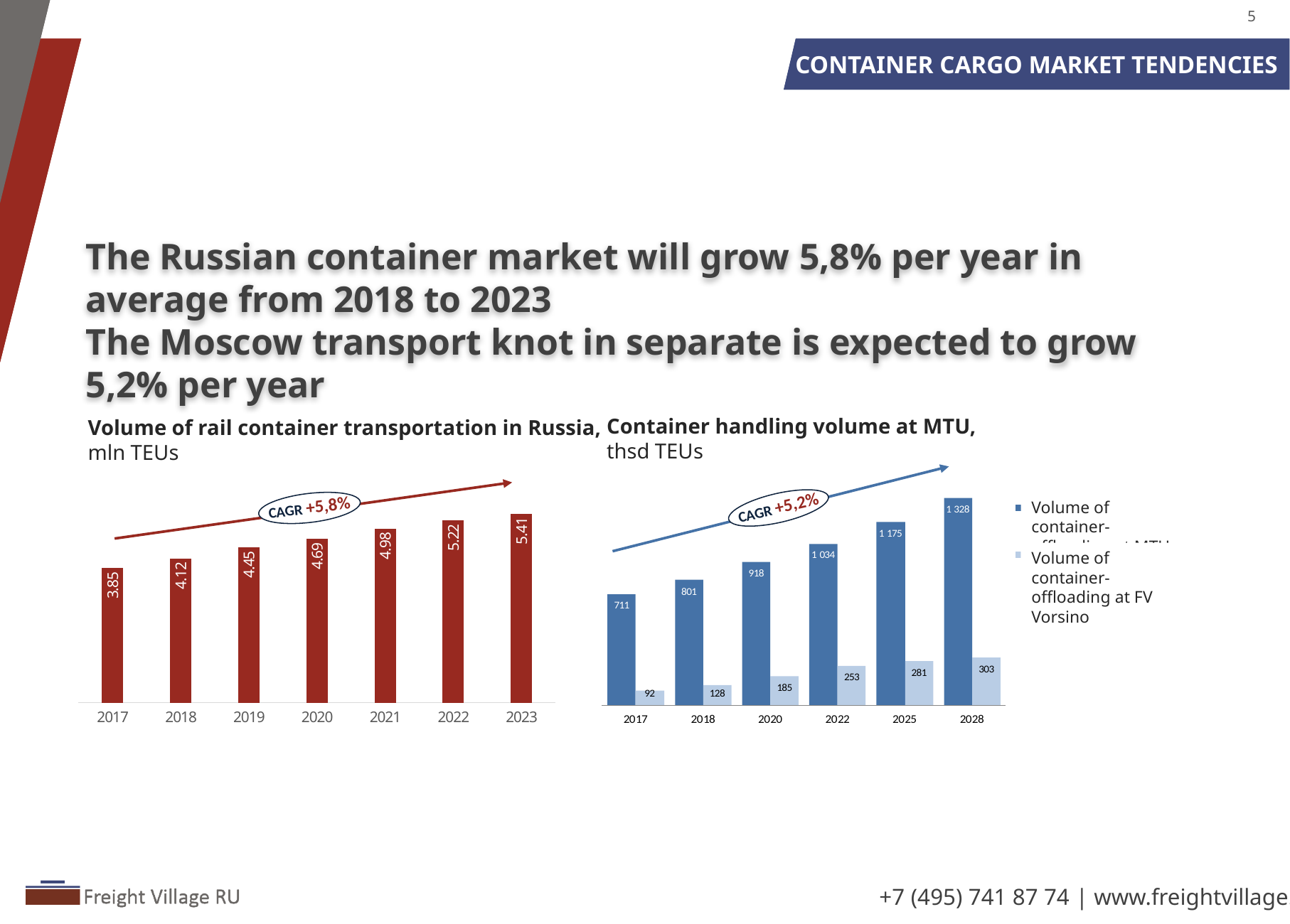
What kind of chart is 'Container handling volume at MTU'? bar chart In the chart 'Volume of rail container transportation in Russia', which year has the highest value? 2023 In the chart 'Volume of rail container transportation in Russia', what is the difference between the 2023 and 2017 values? 1.56 In the chart 'Container handling volume at MTU', what is the value for 'Volume of container-offloading at FV Vorsino' in 2022? 253 In the chart 'Volume of rail container transportation in Russia', how many years are shown on the x axis? 7 In the chart 'Volume of rail container transportation in Russia', what is the value for 2021? 4.98 In the chart 'Volume of rail container transportation in Russia', what is the value for 2017? 3.85 In the chart 'Volume of rail container transportation in Russia', do the values rise or fall from 2017 to 2023? rise In the chart 'Container handling volume at MTU', how many series does the legend list? 2 In the chart 'Container handling volume at MTU', which year has the lowest value for 'Volume of container-offloading at FV Vorsino'? 2017 In the chart 'Container handling volume at MTU', what is the value of the taller (dark blue) series in 2028? 1 328 In the chart 'Container handling volume at MTU', what is the difference between the dark blue series values for 2025 and 2017? 464